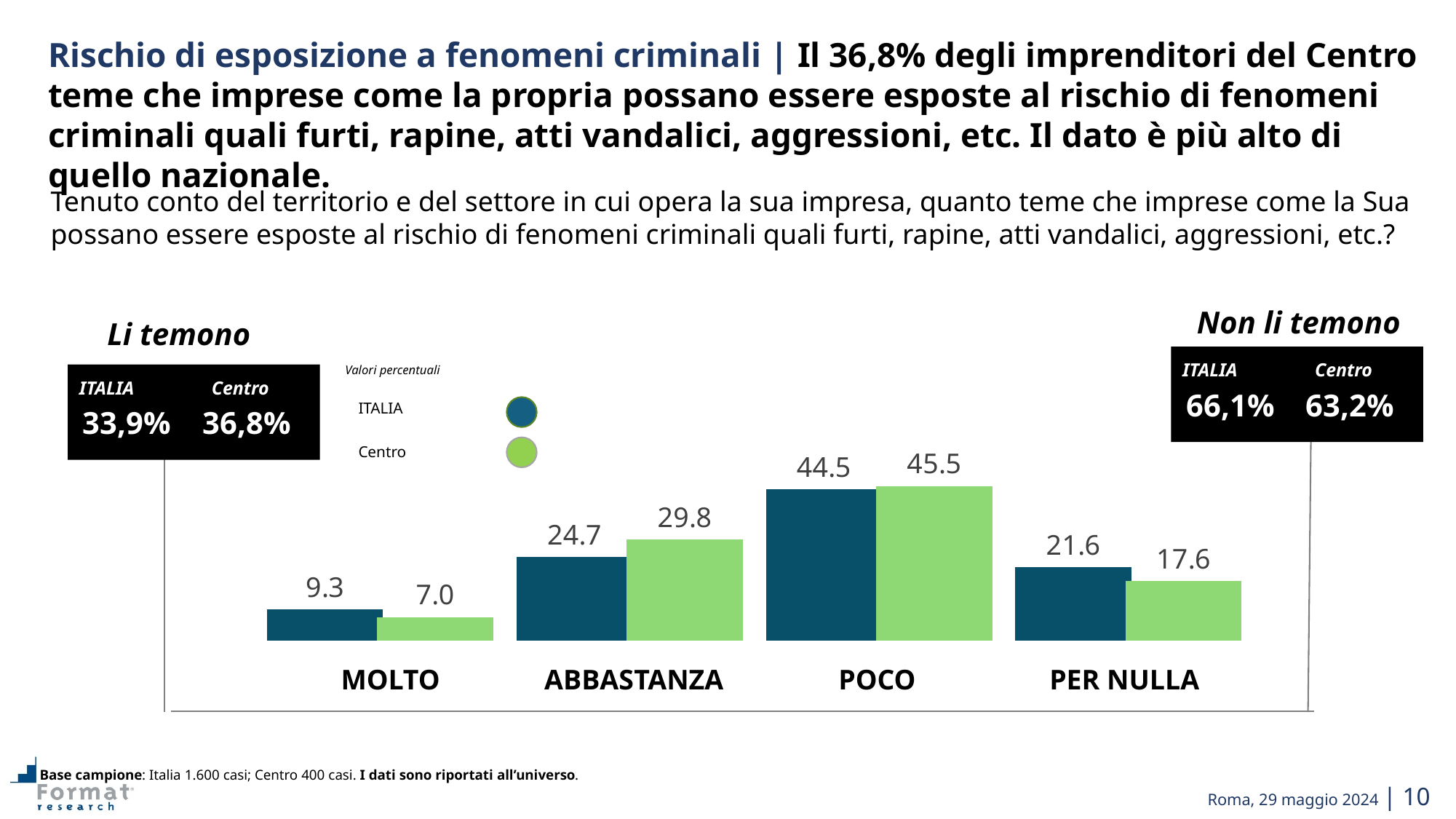
Which colour represents the Centro series in the chart? Green What is the value for ITALIA in the POCO category? 44.5 Which category has the lowest value for the ITALIA series? MOLTO What is the difference between the Centro and ITALIA values in the ABBASTANZA category? 5.1 What is the value for ITALIA in the PER NULLA category? 21.6 How many categories are shown on the x axis of the chart? 4 In the PER NULLA category, which series has the larger value, ITALIA or Centro? ITALIA How many series does the chart legend list? 2 What kind of chart is shown on the slide? Bar chart What is the value for Centro in the MOLTO category? 7.0 Which category has the highest value for the Centro series? POCO What is the value for Centro in the ABBASTANZA category? 29.8